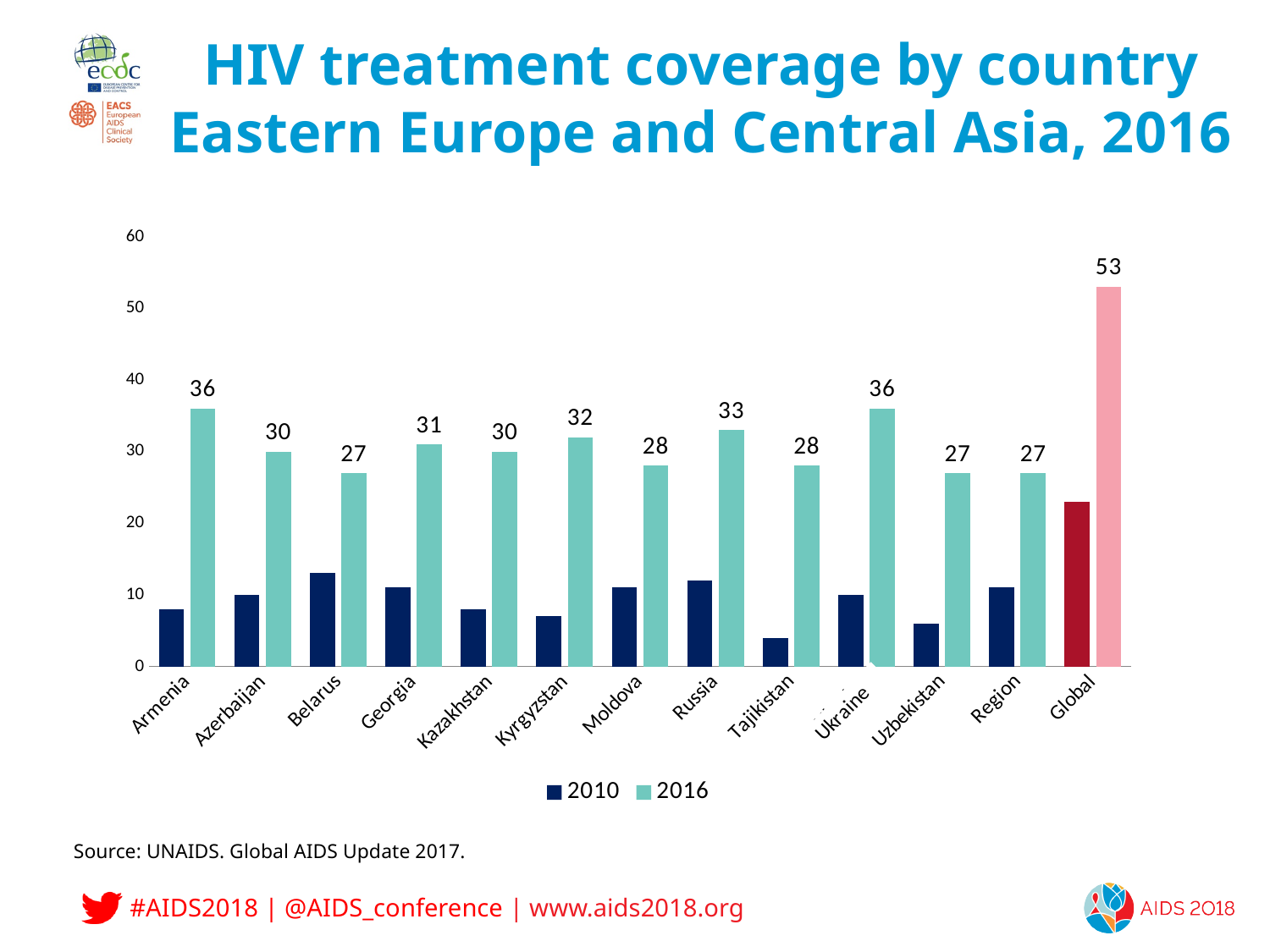
How many categories are shown on the x axis? 13 Is the 2010 value for Tajikistan greater or less than 10? less What is the difference between the 2016 values for Global and Region? 26 What are the two series named in the legend? 2010 and 2016 Which category has the highest 2016 value? Global Is the 2010 value for Belarus greater or less than 10? greater What is the 2016 value for Global? 53 What is the 2016 value for Kyrgyzstan? 32 What kind of chart is shown on the slide? bar chart What is the 2016 value for Russia? 33 How many series does the legend list? 2 Which has a larger 2016 value, Georgia or Moldova? Georgia